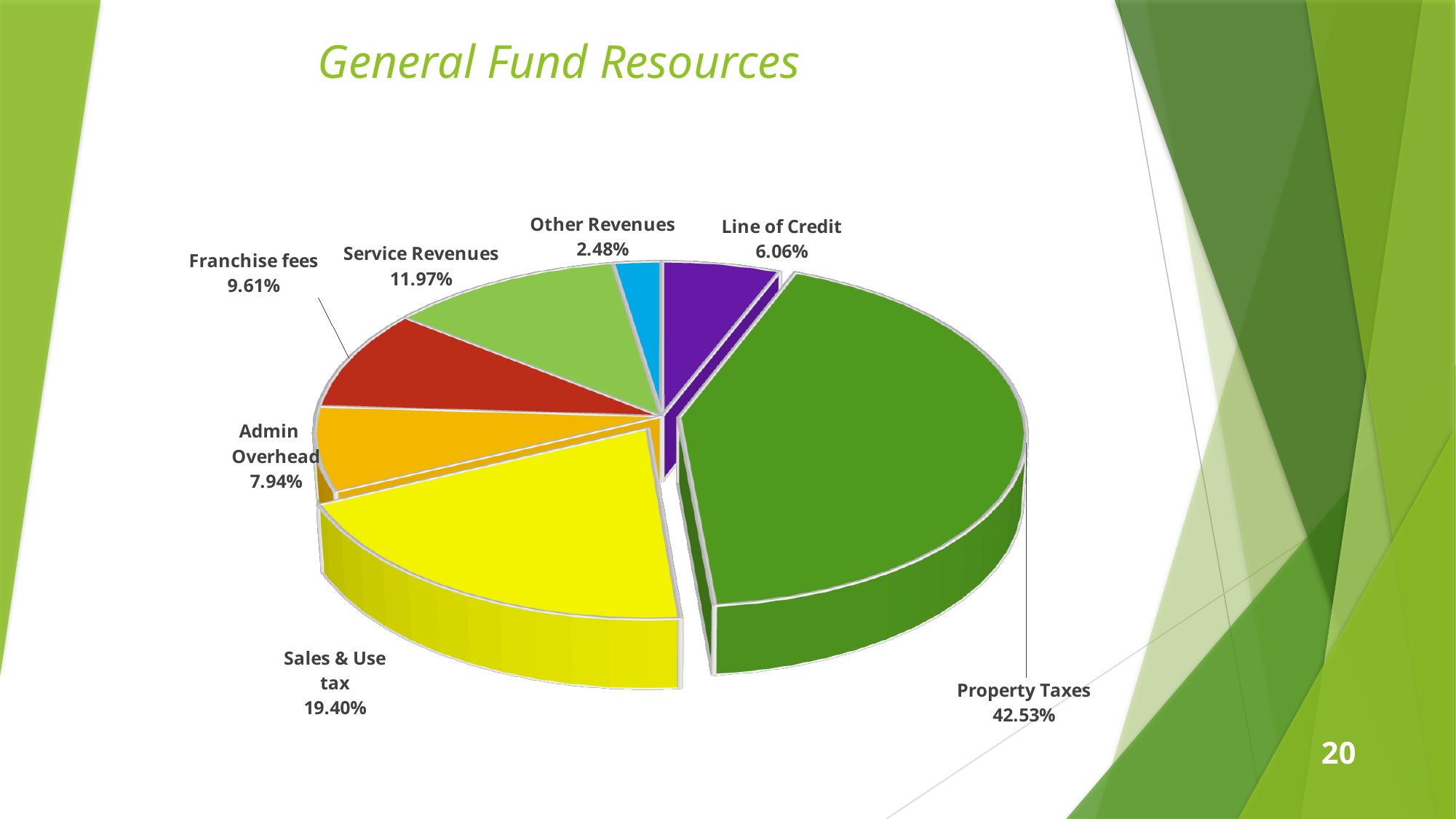
What percentage is shown for Sales & Use tax? 19.40% What is the difference in percentage points between Property Taxes and Sales & Use tax? 23.13 How many categories are shown in the pie chart? 7 Which is larger, Franchise fees or Admin Overhead? Franchise fees Which category has the smallest share of the pie? Other Revenues What percentage is shown for Admin Overhead? 7.94% What share of General Fund Resources comes from Property Taxes? 42.53% Which is larger, Line of Credit or Other Revenues? Line of Credit What type of chart is shown on the slide? Pie chart What is the title of the chart? General Fund Resources What percentage is shown for Service Revenues? 11.97% Which category has the largest share of the pie? Property Taxes